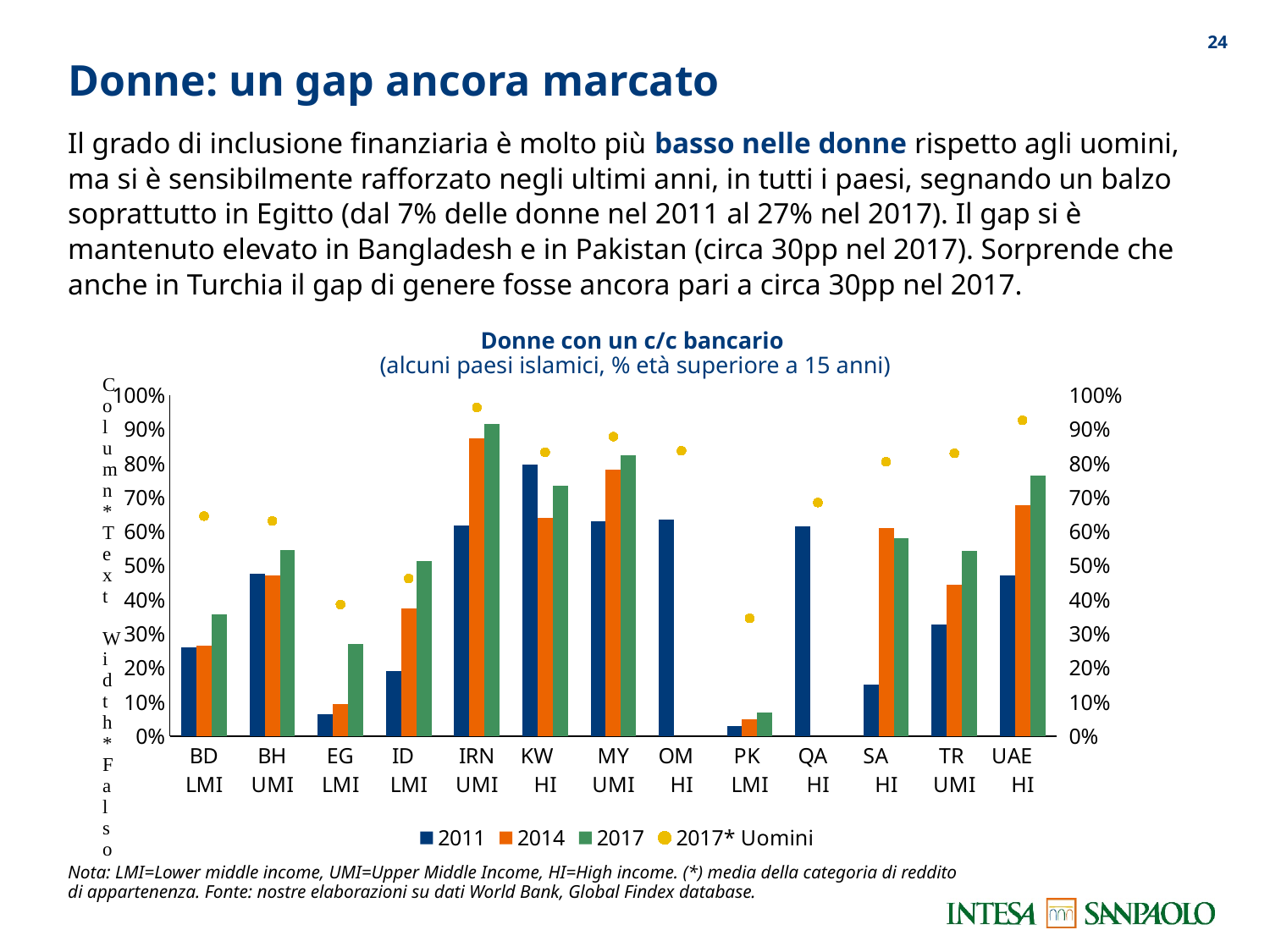
Is the 2011 value for EG greater or less than 10%? less What is the title of the chart? Donne con un c/c bancario Which country has the lowest 2017 value for women with a bank account? PK How many series does the chart legend list? 4 Which is larger, the 2017 value for BD or the 2017 value for BH? BH Which country has the highest 2017 value for women with a bank account? IRN Is the 2017 value for IRN greater or less than 80%? greater What kind of chart is shown on the slide? bar chart Which country has the highest 2011 value in the chart? KW How many countries are shown on the x axis of the chart? 13 Is the 2011 value for SA greater or less than 20%? less